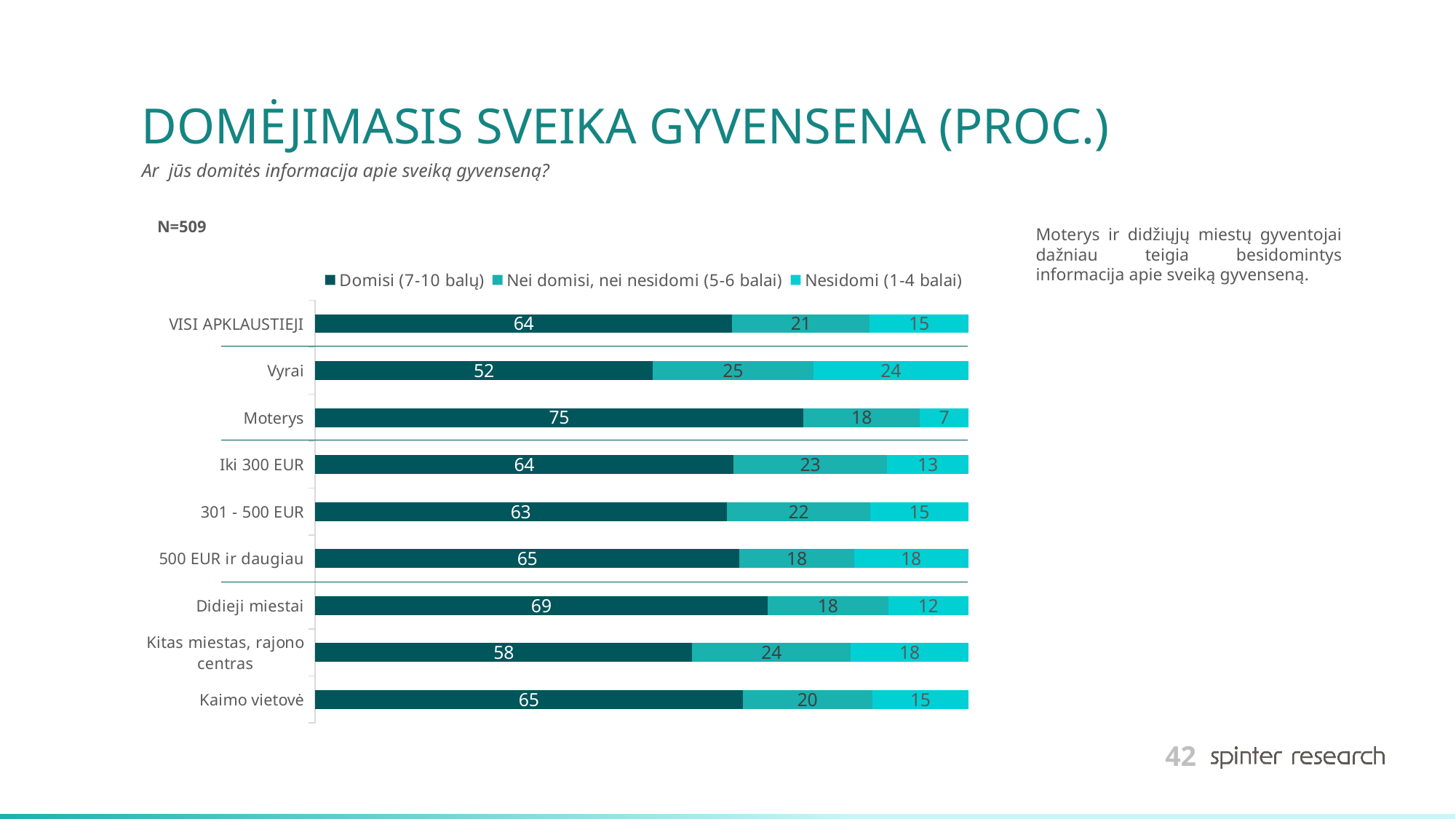
What is the difference between the 'Domisi (7-10 balų)' values for Moterys and Vyrai? 23 Which category has the highest value for 'Domisi (7-10 balų)'? Moterys What is the value of 'Domisi (7-10 balų)' for Moterys? 75 How many categories are shown on the chart? 9 What is the value of 'Nei domisi, nei nesidomi (5-6 balai)' for Iki 300 EUR? 23 What kind of chart is shown on the slide? Stacked bar chart What is the total of the stacked bar for Moterys? 100 How many series does the legend list? 3 Which has a larger 'Nesidomi (1-4 balai)' value, Didieji miestai or Kaimo vietovė? Kaimo vietovė What is the value of 'Nesidomi (1-4 balai)' for Vyrai? 24 What is the value of 'Domisi (7-10 balų)' for Kitas miestas, rajono centras? 58 Which category has the lowest value for 'Domisi (7-10 balų)'? Vyrai